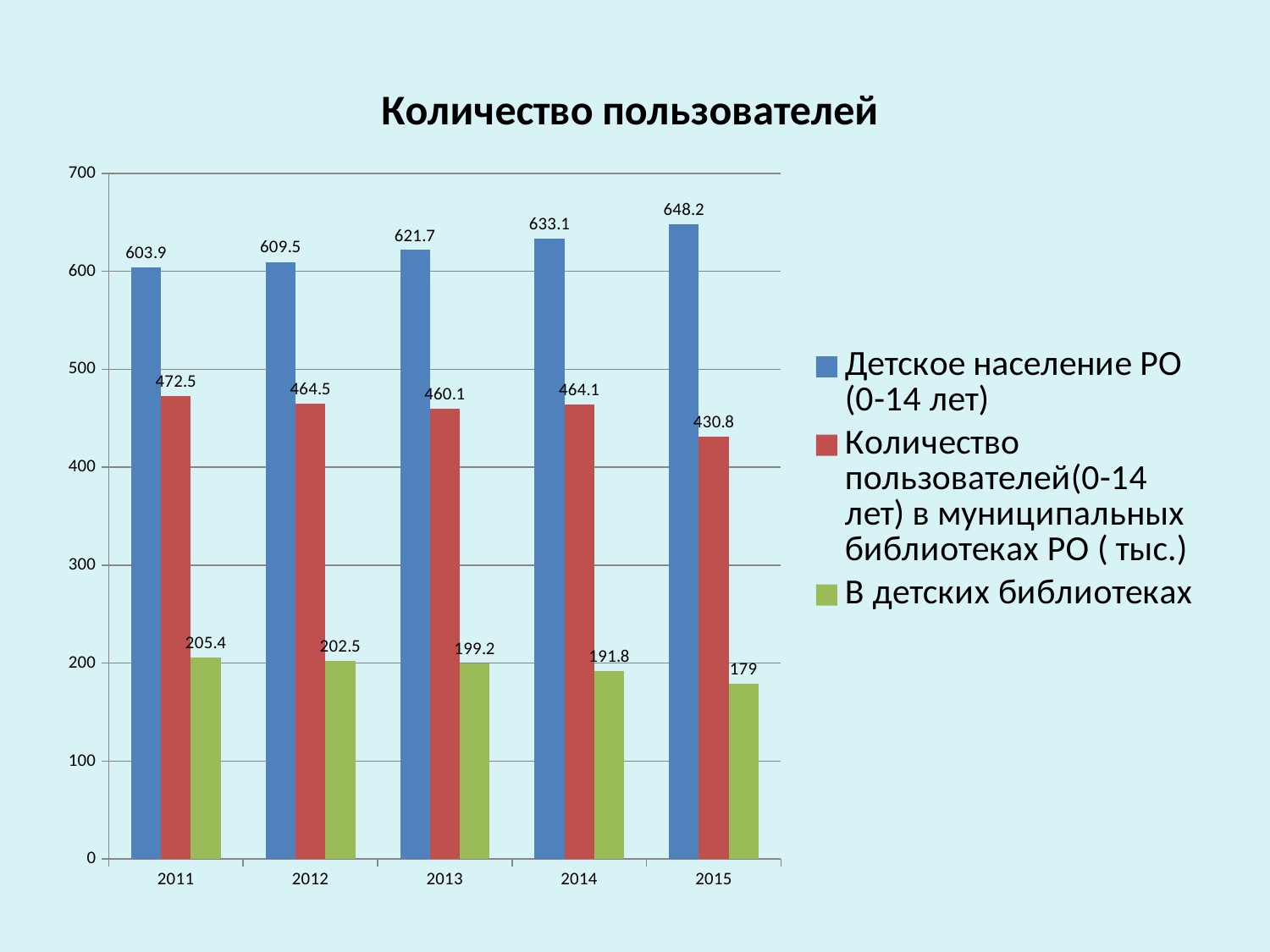
How many series does the legend list? 3 What kind of chart is shown on the slide? bar chart What is the value for Детское население РО (0-14 лет) in 2015? 648.2 What is the difference between the Детское население РО (0-14 лет) values for 2015 and 2011? 44.3 In which year is the value for Детское население РО (0-14 лет) highest? 2015 Is the value for В детских библиотеках in 2014 greater or less than 200? less What is the value for В детских библиотеках in 2011? 205.4 In which year is the value for В детских библиотеках lowest? 2015 Which is larger: the Количество пользователей(0-14 лет) в муниципальных библиотеках РО ( тыс.) value for 2011 or for 2015? 2011 How many years are shown on the x axis? 5 Do the values for В детских библиотеках rise or fall from 2011 to 2015? fall What is the value for Количество пользователей(0-14 лет) в муниципальных библиотеках РО ( тыс.) in 2013? 460.1